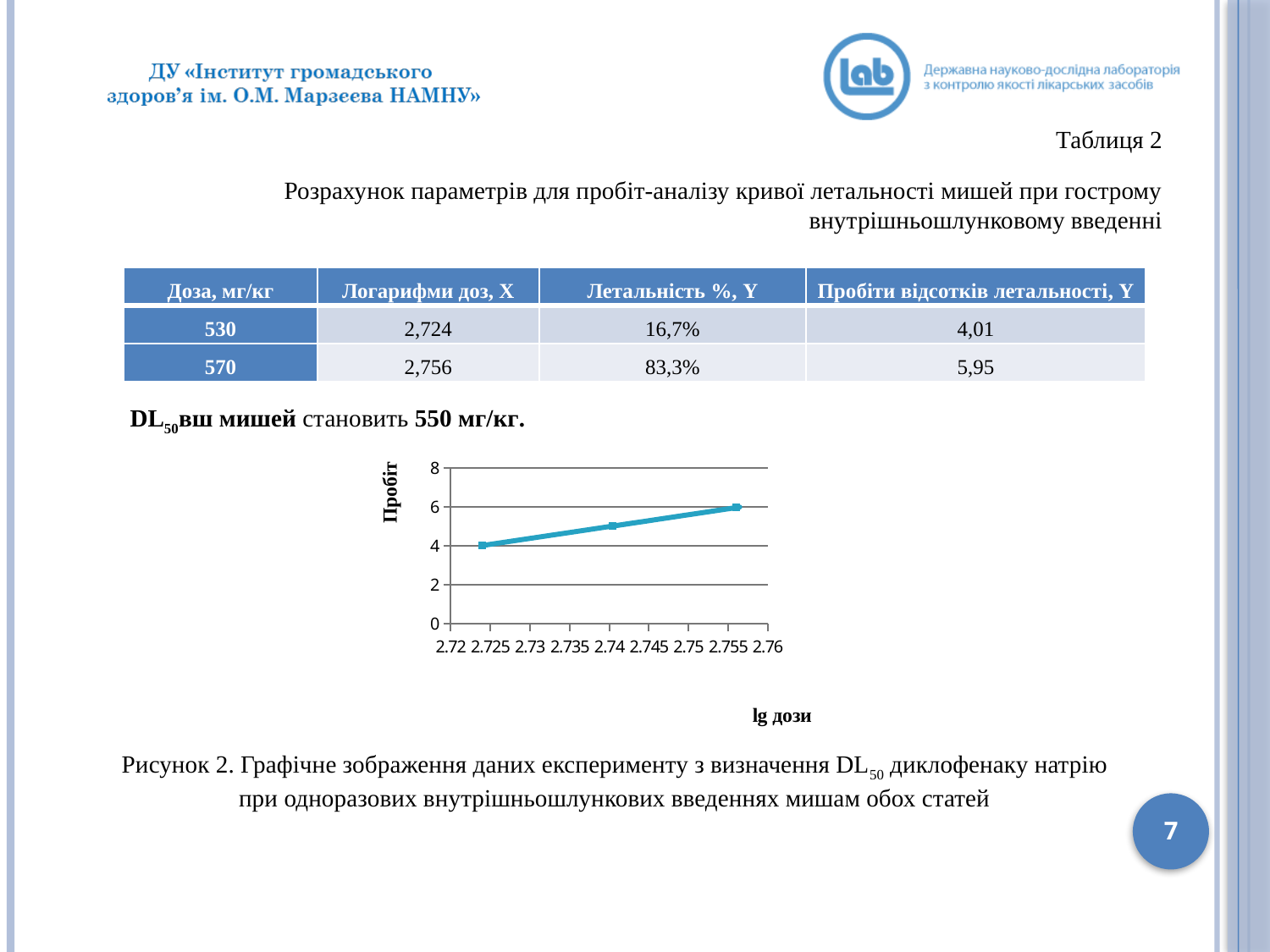
Is the value of the rightmost point on the line chart greater or less than 4? greater Is the value of the leftmost point on the line chart greater or less than 2? greater What is the label of the vertical axis of the chart? Пробіт Which point on the line chart has the highest Пробіт value, the leftmost or the rightmost? rightmost What kind of chart is shown on the slide? line chart Is the value of the middle point on the line chart greater or less than 6? less What is the label of the horizontal axis of the chart? lg дози Which point on the line chart has the lowest Пробіт value, the leftmost or the rightmost? leftmost How many data points are plotted on the line chart? 3 Do the plotted values rise or fall as lg дози increases along the x axis? rise